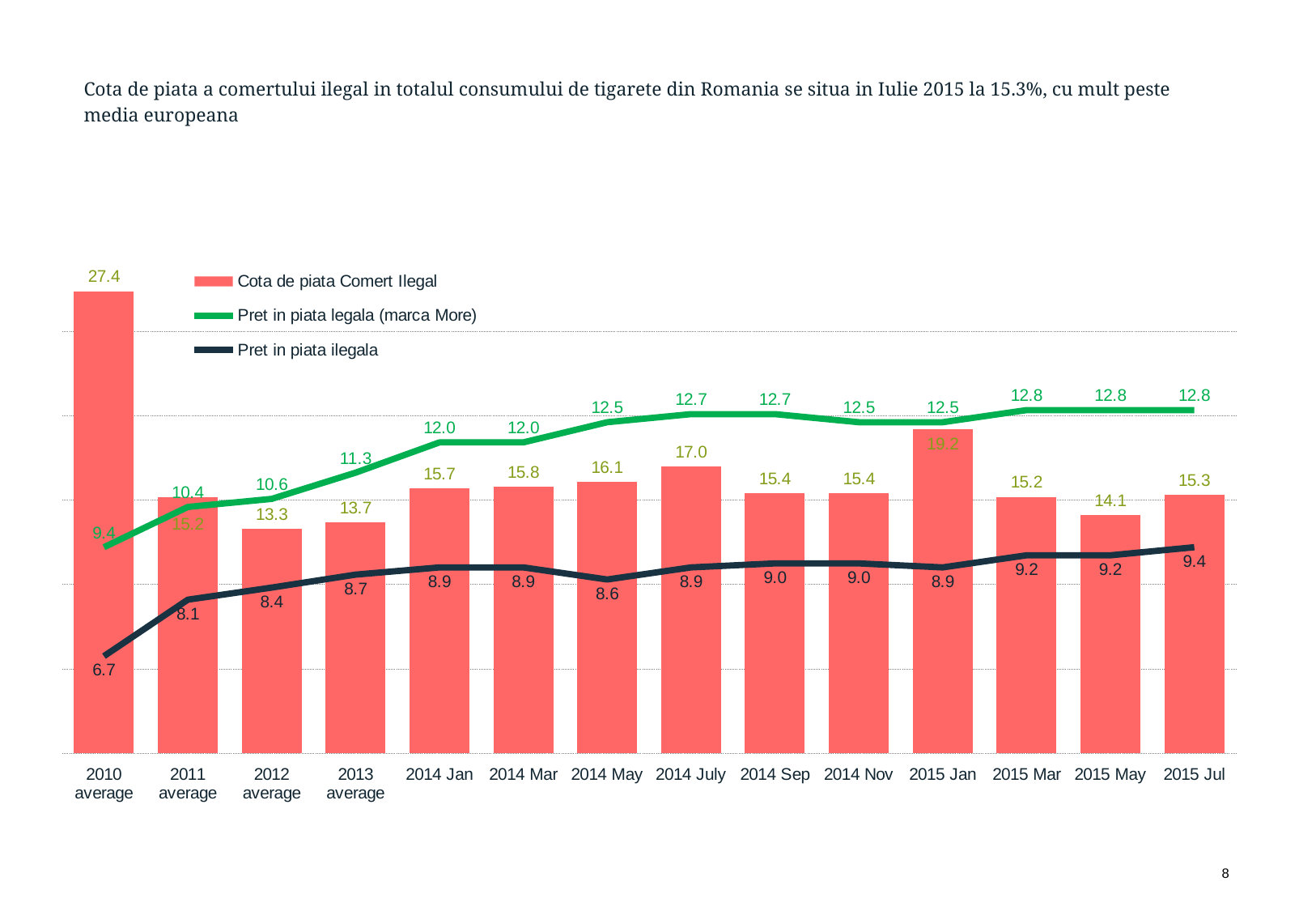
How many categories are shown on the x axis? 14 How many series does the legend list? 3 What is the difference between the Cota de piata Comert Ilegal values for 2010 average and 2015 Jul? 12.1 What kind of chart is shown on the slide? Combined bar and line chart Which category has the lowest value for Cota de piata Comert Ilegal? 2012 average What is the value of Pret in piata legala (marca More) for 2015 Jul? 12.8 What is the value of Pret in piata ilegala for 2010 average? 6.7 Which is larger, the Cota de piata Comert Ilegal value for 2014 July or for 2015 Jan? 2015 Jan Does the Pret in piata legala (marca More) line generally rise or fall from 2010 average to 2015 Jul? Rise Which category has the highest value for Cota de piata Comert Ilegal? 2010 average What is the value of Cota de piata Comert Ilegal for 2015 Jul? 15.3 What is the difference between Pret in piata legala (marca More) and Pret in piata ilegala for 2015 Jul? 3.4